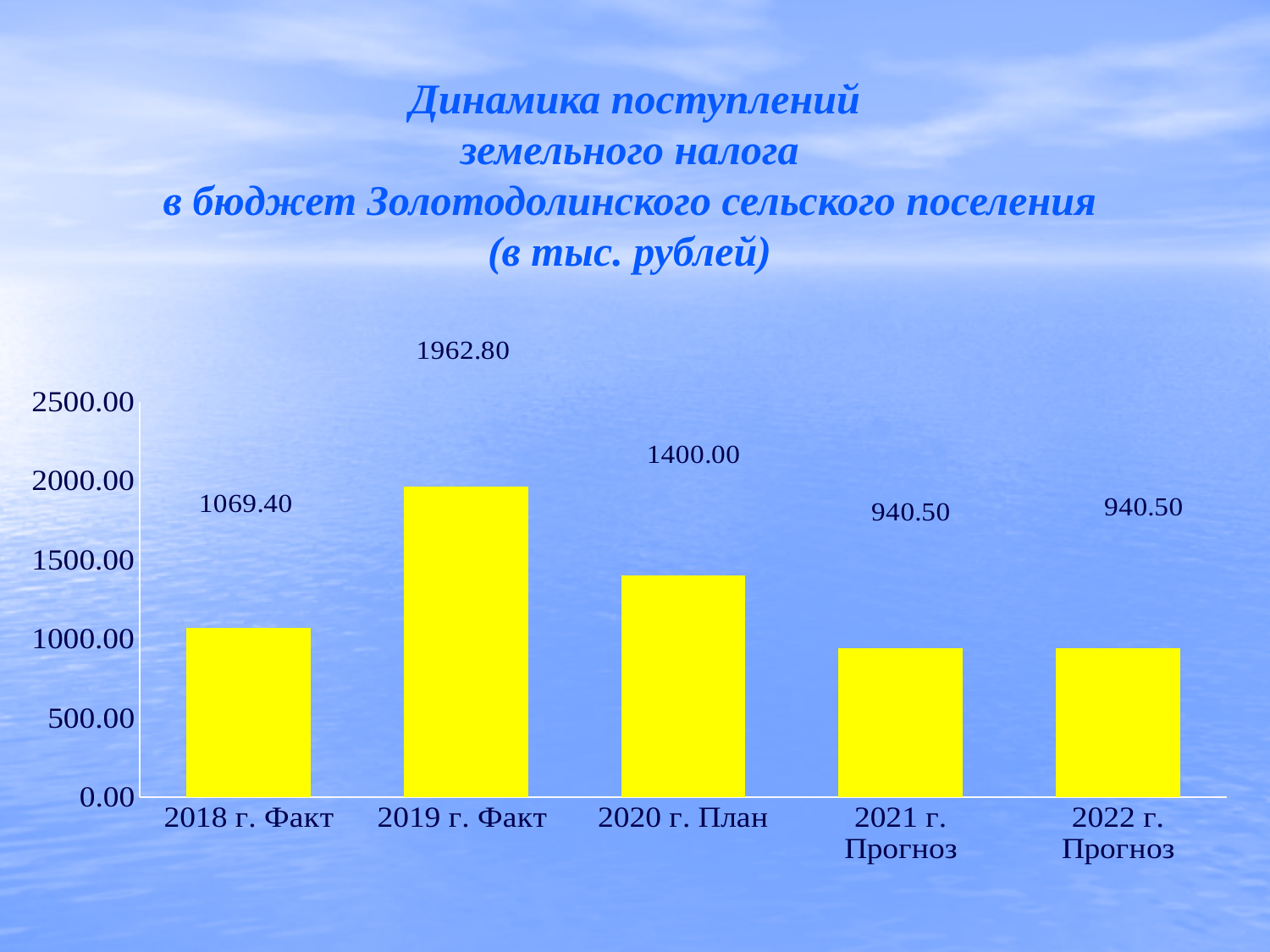
What is the value for 2020 г. План? 1400.00 What is the difference between the values for 2019 г. Факт and 2020 г. План? 562.80 Is the value for 2022 г. Прогноз greater or less than 1000.00? less Which is larger, the value for 2018 г. Факт or the value for 2020 г. План? 2020 г. План What is the difference between the values for 2018 г. Факт and 2021 г. Прогноз? 128.90 What is the value for 2018 г. Факт? 1069.40 What is the value for 2019 г. Факт? 1962.80 What is the value for 2021 г. Прогноз? 940.50 What kind of chart is shown on the slide? bar chart How many categories are shown on the x axis? 5 Which category has the highest value? 2019 г. Факт What colour are the bars in the chart? yellow